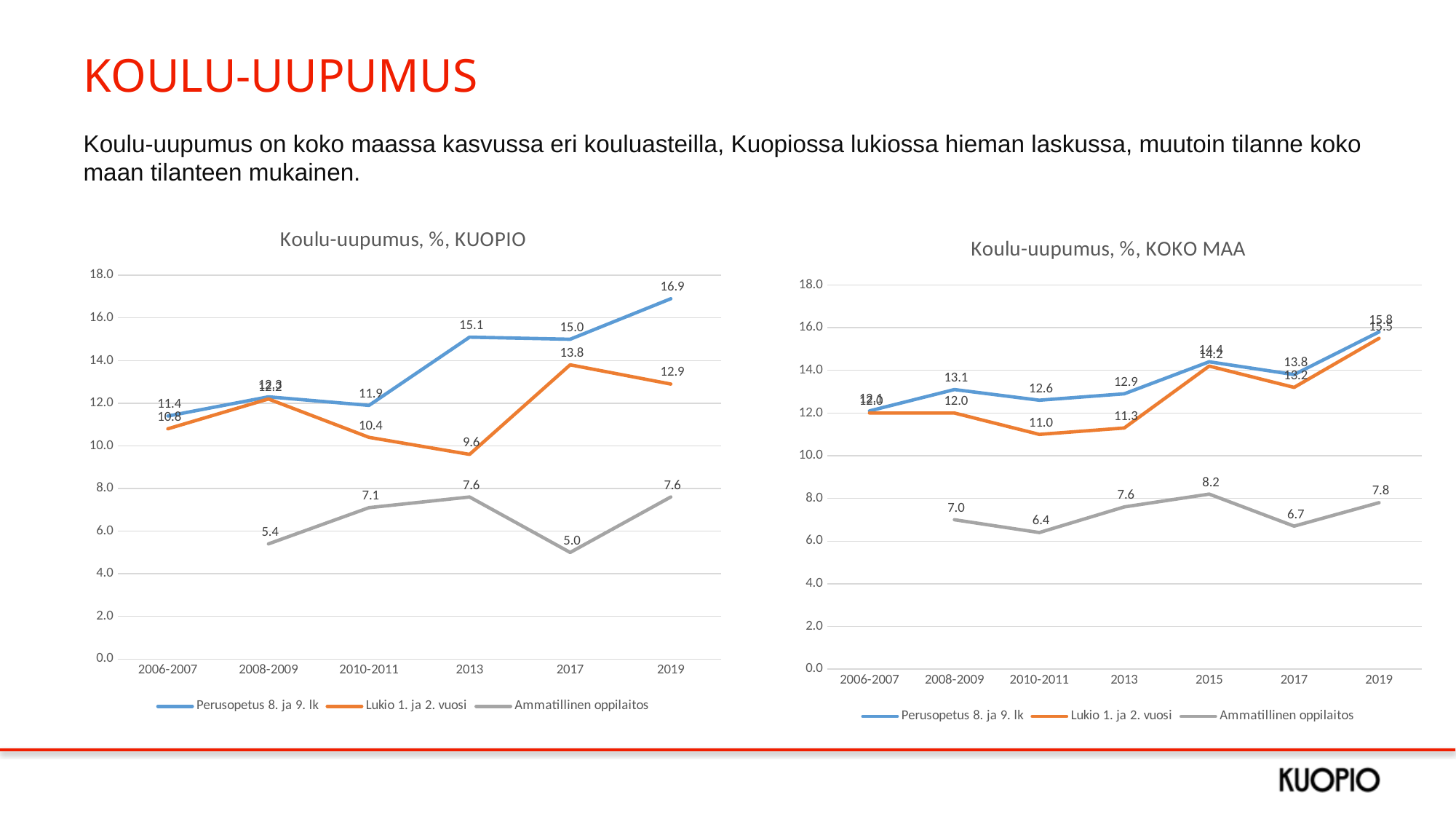
In the Koulu-uupumus, %, KUOPIO chart, what is the difference between the Perusopetus 8. ja 9. lk value and the Lukio 1. ja 2. vuosi value in 2019? 4.0 In the Koulu-uupumus, %, KOKO MAA chart, what is the value for Ammatillinen oppilaitos in 2015? 8.2 In the Koulu-uupumus, %, KOKO MAA chart, in which year is the Ammatillinen oppilaitos value lowest? 2010-2011 In the Koulu-uupumus, %, KUOPIO chart, what is the value for Perusopetus 8. ja 9. lk in 2019? 16.9 In the Koulu-uupumus, %, KUOPIO chart, how many categories are shown on the x axis? 6 In the Koulu-uupumus, %, KUOPIO chart, in which year is the Lukio 1. ja 2. vuosi value highest? 2017 In the Koulu-uupumus, %, KOKO MAA chart, what is the value for Lukio 1. ja 2. vuosi in 2010-2011? 11.0 In the Koulu-uupumus, %, KOKO MAA chart, which is larger in 2017: Perusopetus 8. ja 9. lk or Ammatillinen oppilaitos? Perusopetus 8. ja 9. lk What kind of chart is the Koulu-uupumus, %, KOKO MAA chart? line chart In the Koulu-uupumus, %, KUOPIO chart, what is the value for Ammatillinen oppilaitos in 2017? 5.0 In the Koulu-uupumus, %, KUOPIO chart, what is the value for Lukio 1. ja 2. vuosi in 2013? 9.6 In the Koulu-uupumus, %, KOKO MAA chart, how many series does the legend list? 3